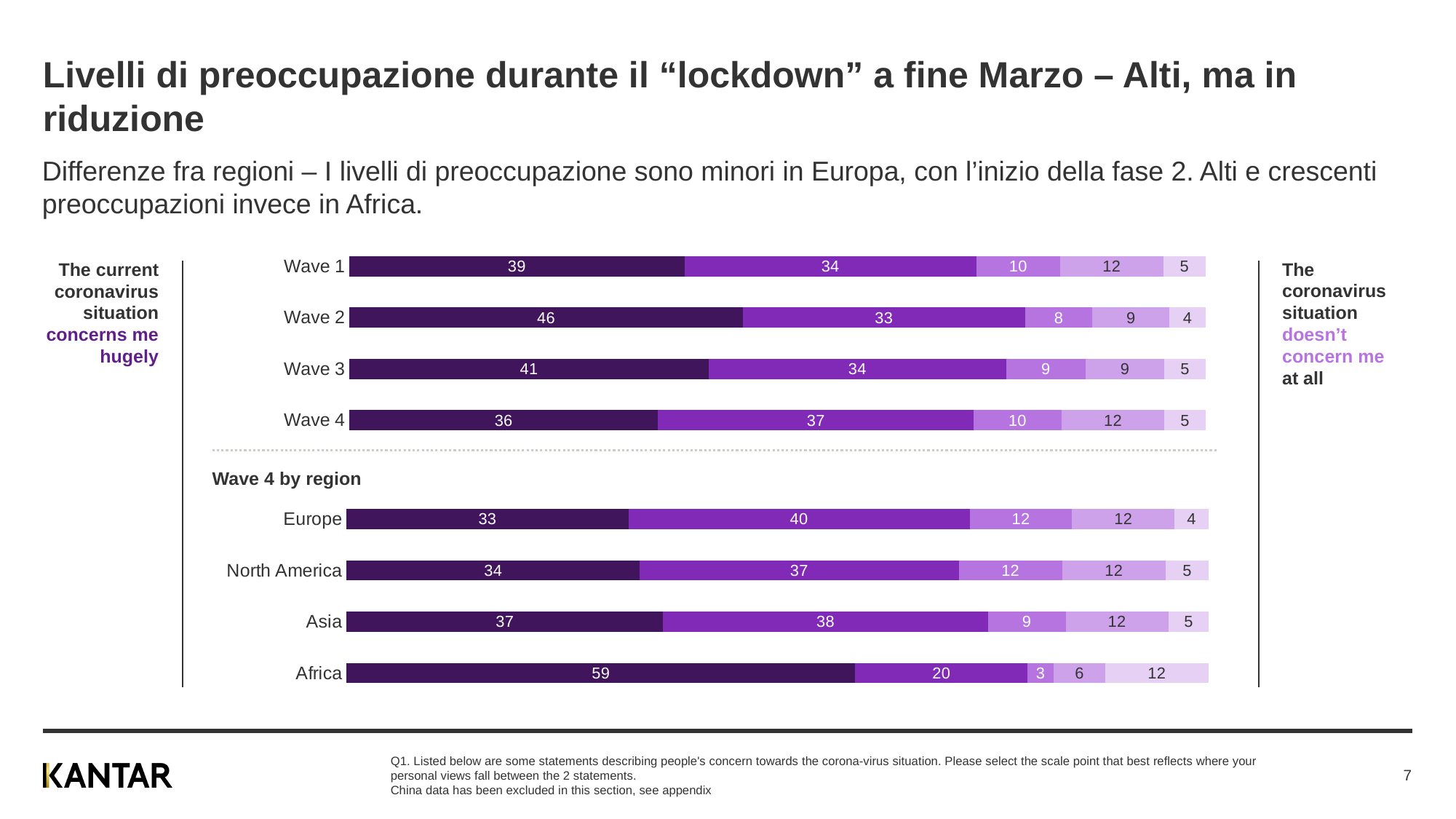
What is the value of the second segment (second-darkest) for Europe? 40 Which has a larger darkest segment value, Europe or Asia? Asia What is the total of all segments in the Wave 1 bar? 100 What is the value of the darkest ("concerns me hugely") segment for Africa? 59 How many bars are shown in the chart in total? 8 Among the Wave 4 regions, which region has the largest darkest ("concerns me hugely") segment? Africa What does the label on the left side of the chart say the darkest segment represents? The current coronavirus situation concerns me hugely What is the value of the darkest segment for Wave 2? 46 What kind of chart is shown on the slide? Stacked bar chart Among Wave 1 to Wave 4, which wave has the smallest darkest ("concerns me hugely") segment? Wave 4 What is the value of the lightest (rightmost) segment for Africa? 12 What is the difference between the darkest segment values of Wave 2 and Wave 4? 10